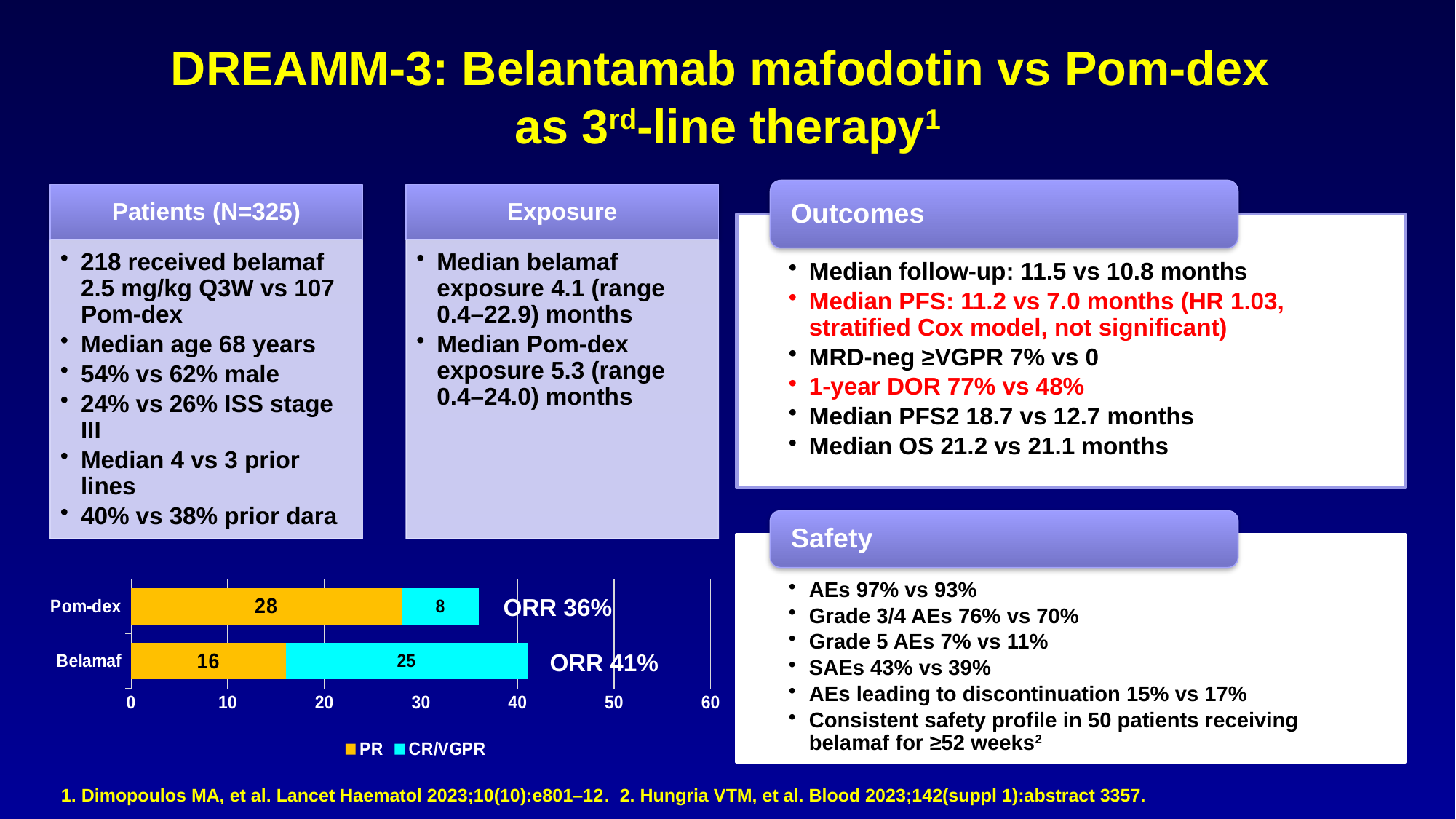
What is the total of the stacked bar for Belamaf? 41 Which arm has the higher CR/VGPR value? Belamaf What is the CR/VGPR value for Pom-dex in the bar chart? 8 How many categories (treatment arms) are shown in the bar chart? 2 Which arm has the larger PR value, Pom-dex or Belamaf? Pom-dex What is the difference between the CR/VGPR values for Belamaf and Pom-dex? 17 What kind of chart is shown on the slide? Stacked bar chart What is the CR/VGPR value for Belamaf in the bar chart? 25 What is the PR value for Pom-dex in the bar chart? 28 What is the PR value for Belamaf in the bar chart? 16 What is the total of the stacked bar for Pom-dex? 36 How many series does the chart legend list? 2